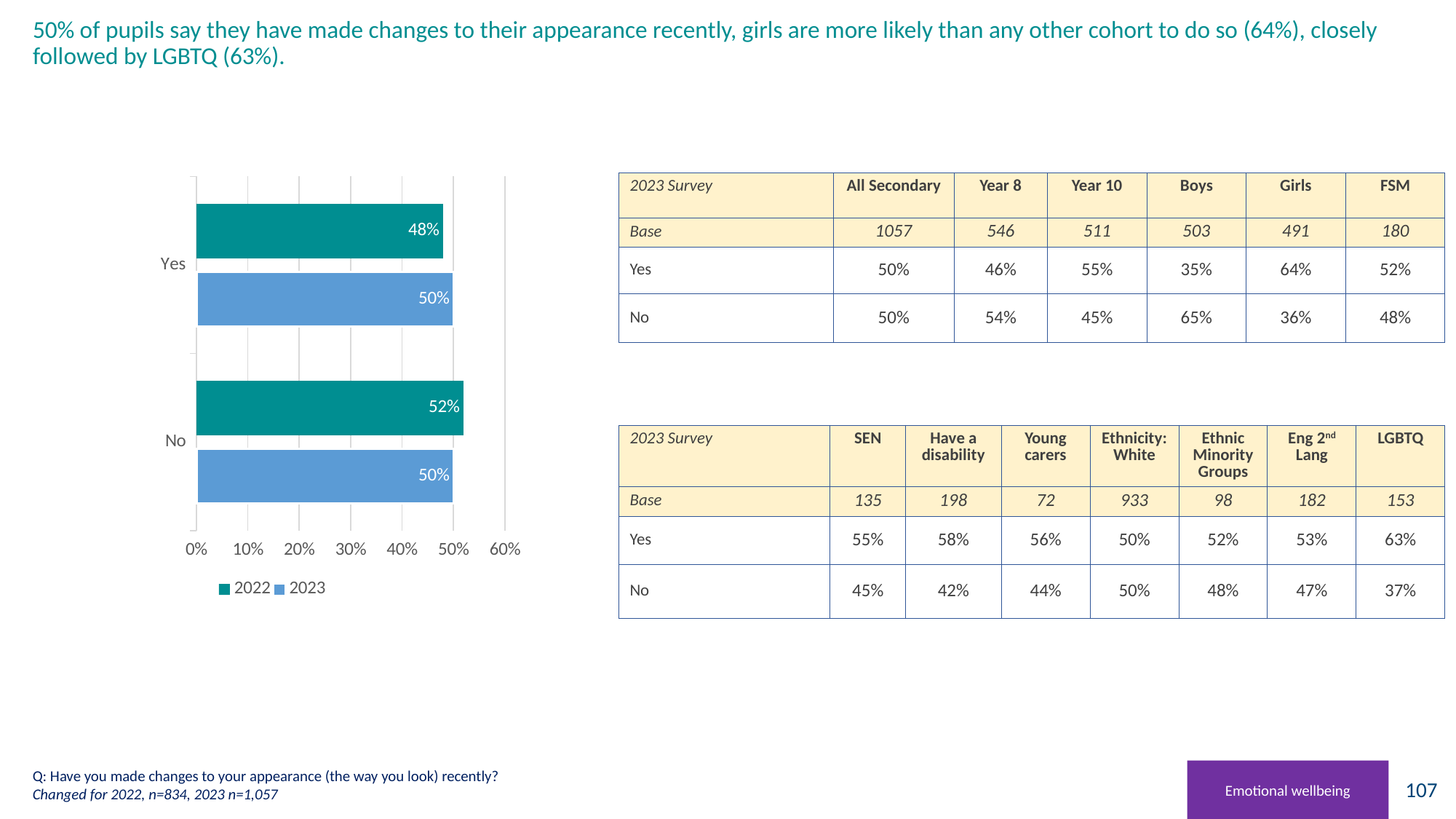
How many categories are shown on the chart? 2 Which category has the lowest 2022 value? Yes What is the 2022 value for No? 52% What is the 2023 value for Yes? 50% What is the 2022 value for Yes? 48% What is the 2023 value for No? 50% What kind of chart is shown on the slide? Bar chart Is the 2022 value for No greater or less than 50%? greater Which category has the highest 2022 value? No Which is larger for Yes: the 2022 value or the 2023 value? 2023 What is the difference between the 2022 values for No and Yes? 4% How many series does the legend list? 2